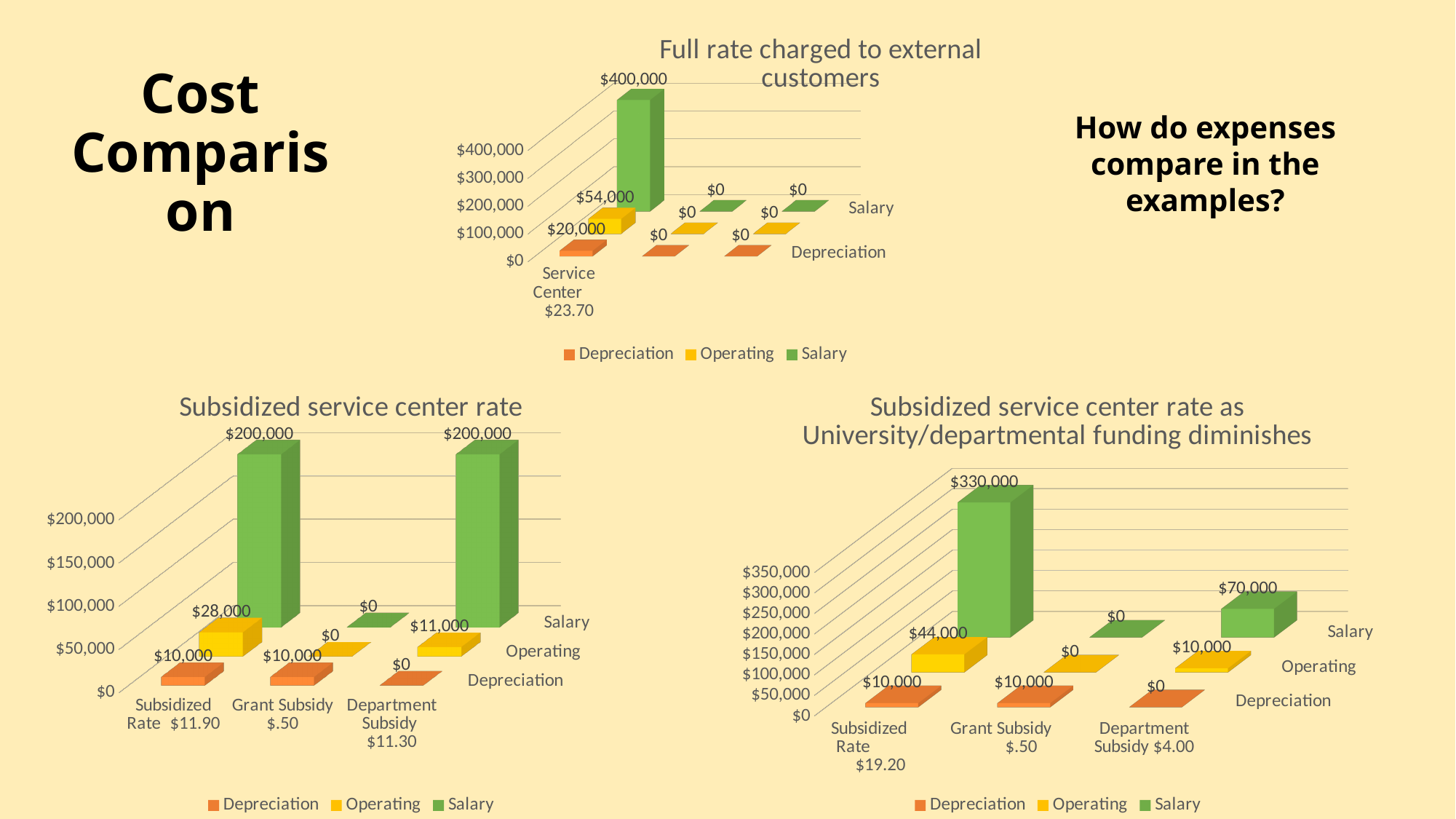
In the 'Subsidized service center rate as University/departmental funding diminishes' chart, is the Salary value for Subsidized Rate $19.20 larger or smaller than the Salary value for Department Subsidy $4.00? larger In the 'Full rate charged to external customers' chart, what is the Operating value for Service Center $23.70? $54,000 In the 'Full rate charged to external customers' chart, what is the Salary value for Service Center $23.70? $400,000 In the 'Subsidized service center rate as University/departmental funding diminishes' chart, which category has the highest Operating value? Subsidized Rate $19.20 In the 'Subsidized service center rate' chart, what is the difference between the Operating values for Subsidized Rate $11.90 and Department Subsidy $11.30? $17,000 In the 'Full rate charged to external customers' chart, what is the Depreciation value for Service Center $23.70? $20,000 In the 'Subsidized service center rate as University/departmental funding diminishes' chart, what is the Salary value for Department Subsidy $4.00? $70,000 How many series does the legend of the 'Subsidized service center rate' chart list? 3 In the 'Subsidized service center rate as University/departmental funding diminishes' chart, what is the Salary value for Subsidized Rate $19.20? $330,000 In the 'Subsidized service center rate' chart, what is the Operating value for Subsidized Rate $11.90? $28,000 What kind of chart is the 'Subsidized service center rate' chart? bar chart In the 'Subsidized service center rate' chart, what is the Salary value for Department Subsidy $11.30? $200,000